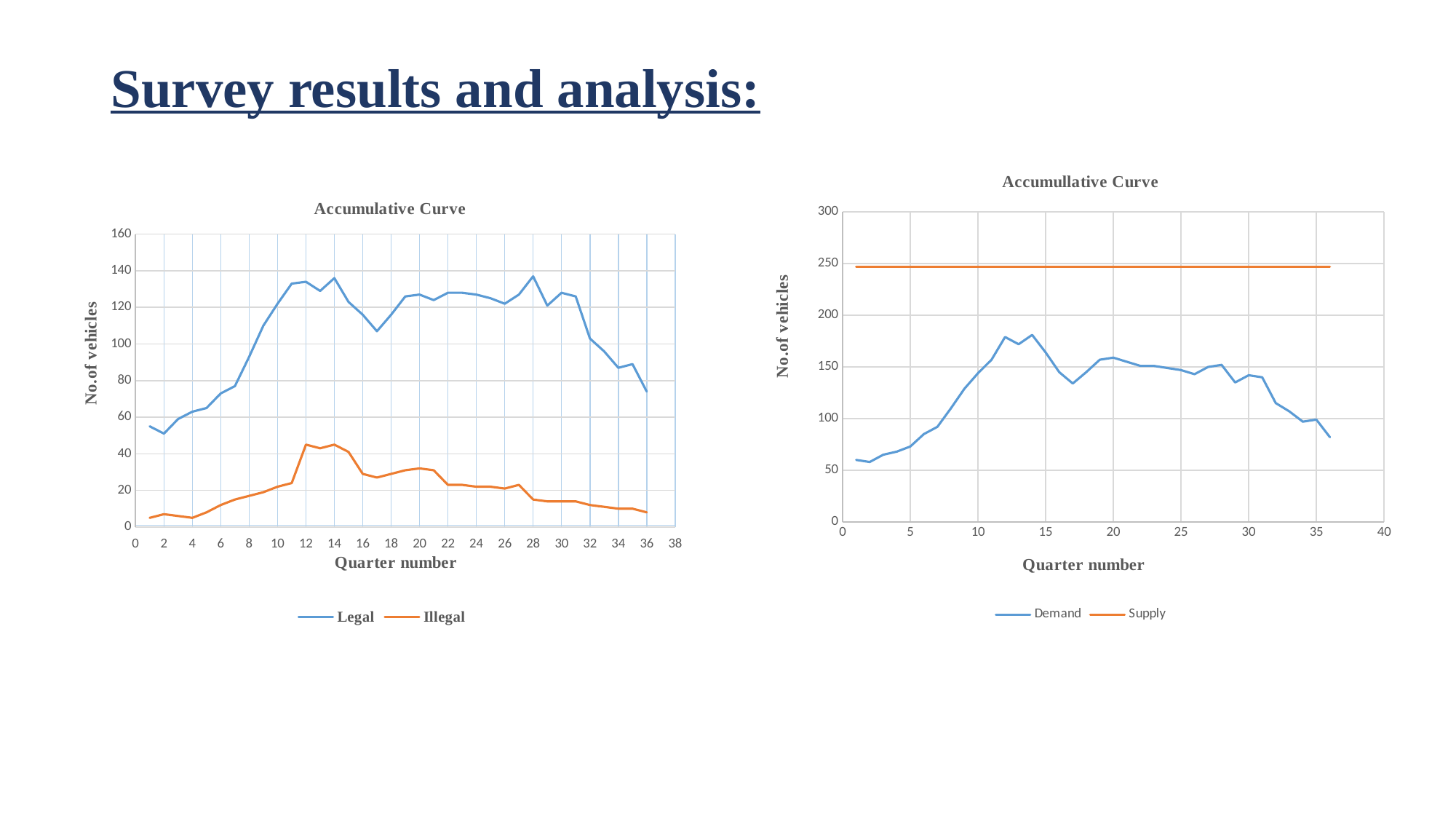
In the right chart, is the Demand value at quarter 36 greater or less than 100? less In the right chart, does the Demand line rise or fall between quarter 1 and quarter 12? rise What kind of chart is the left chart titled 'Accumulative Curve'? line chart In the left chart, is the Illegal value at quarter 12 greater or less than 30? greater In the right chart, is the Supply value greater or less than 200? greater How many series does the legend of the left chart list? 2 In the left chart, which series has the higher value at quarter 20, Legal or Illegal? Legal What are the two series named in the legend of the right chart? Demand and Supply In the right chart, which series is higher at quarter 10, Demand or Supply? Supply